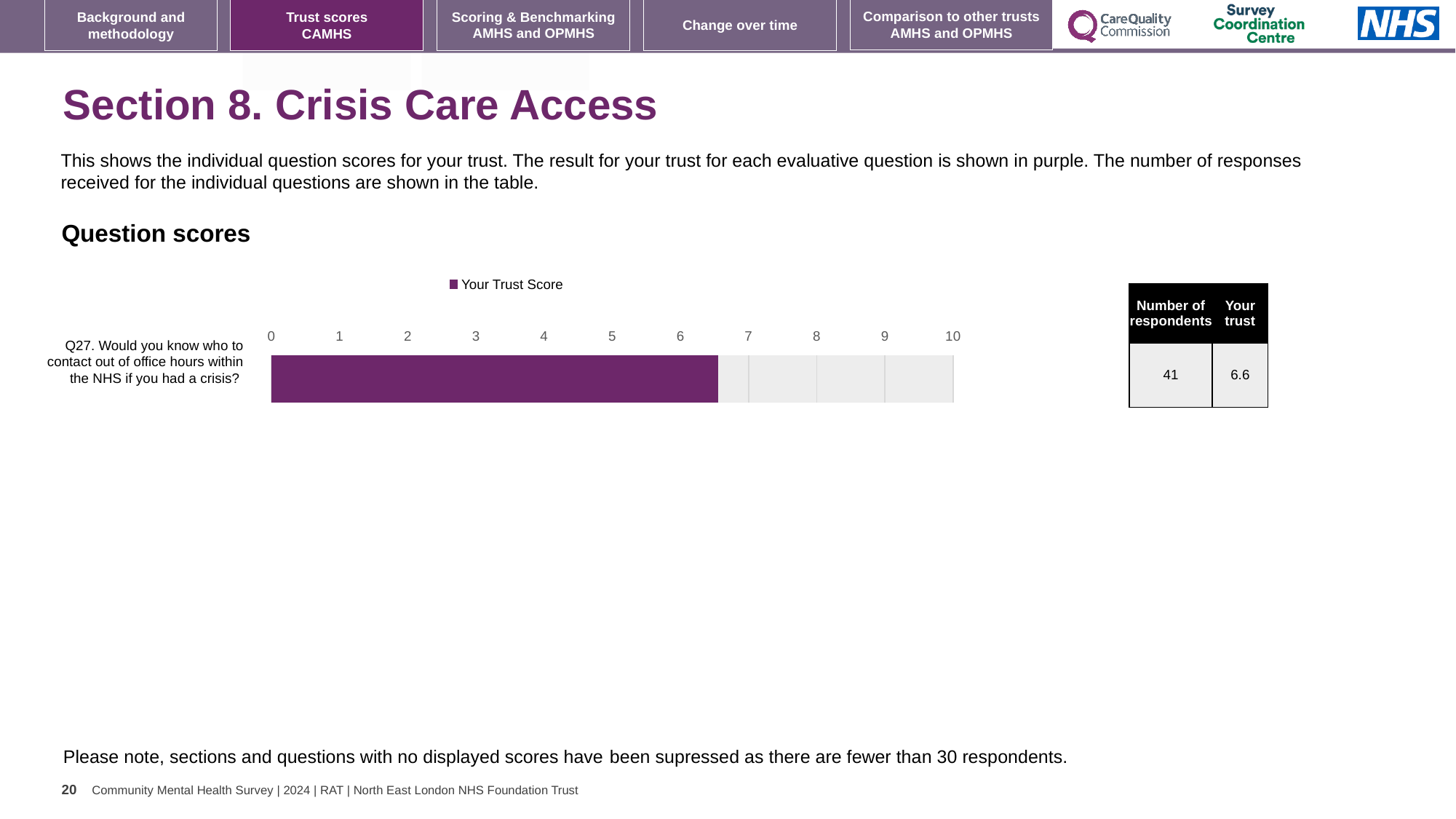
How many series does the legend of the Question scores chart list? 1 Is the bar for Q27 in the Question scores chart greater or less than 8? less What is the legend entry shown above the Question scores chart? Your Trust Score Is the bar for Q27 in the Question scores chart greater or less than 5? greater Is the bar for Q27 in the Question scores chart greater or less than 7? less What is the highest value shown on the x axis of the Question scores chart? 10 How many questions (categories) are plotted in the Question scores chart? 1 According to the table beside the Question scores chart, what is the "Your trust" score for Q27? 6.6 What kind of chart is shown under the heading "Question scores"? bar chart According to the table beside the Question scores chart, how many respondents answered Q27? 41